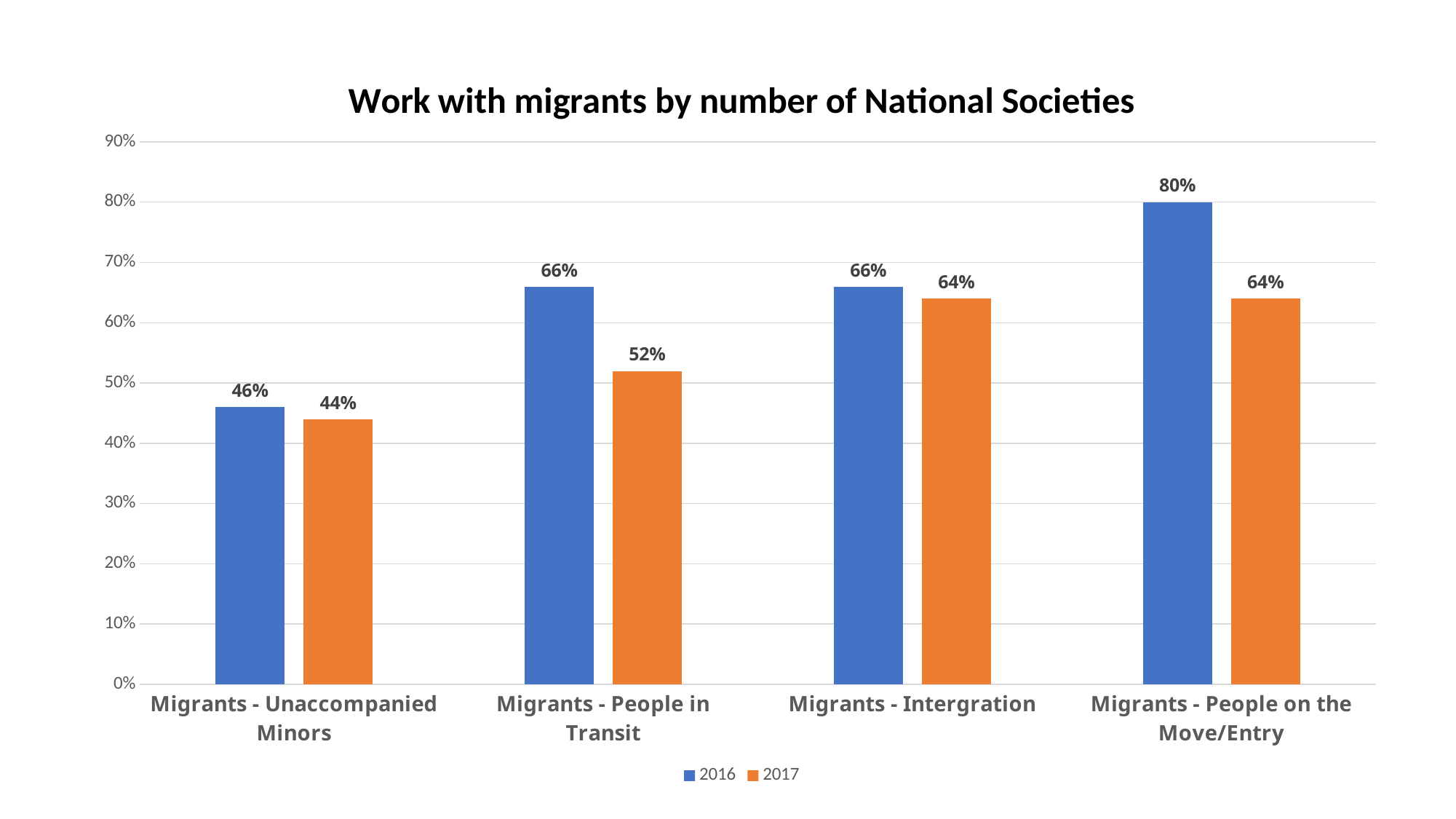
How many categories are shown on the x axis? 4 Which is larger: the 2016 value for Migrants - Intergration or the 2017 value for Migrants - Intergration? 2016 How many series does the legend list? 2 What is the 2016 value for Migrants - People on the Move/Entry? 80% What is the 2017 value for Migrants - People in Transit? 52% Which category has the highest 2016 value? Migrants - People on the Move/Entry What kind of chart is shown on the slide? Bar chart What is the title of the chart? Work with migrants by number of National Societies What is the difference between the 2016 and 2017 values for Migrants - People on the Move/Entry? 16% What is the difference between the 2016 and 2017 values for Migrants - People in Transit? 14% What is the 2017 value for Migrants - Unaccompanied Minors? 44% Which category has the lowest 2017 value? Migrants - Unaccompanied Minors